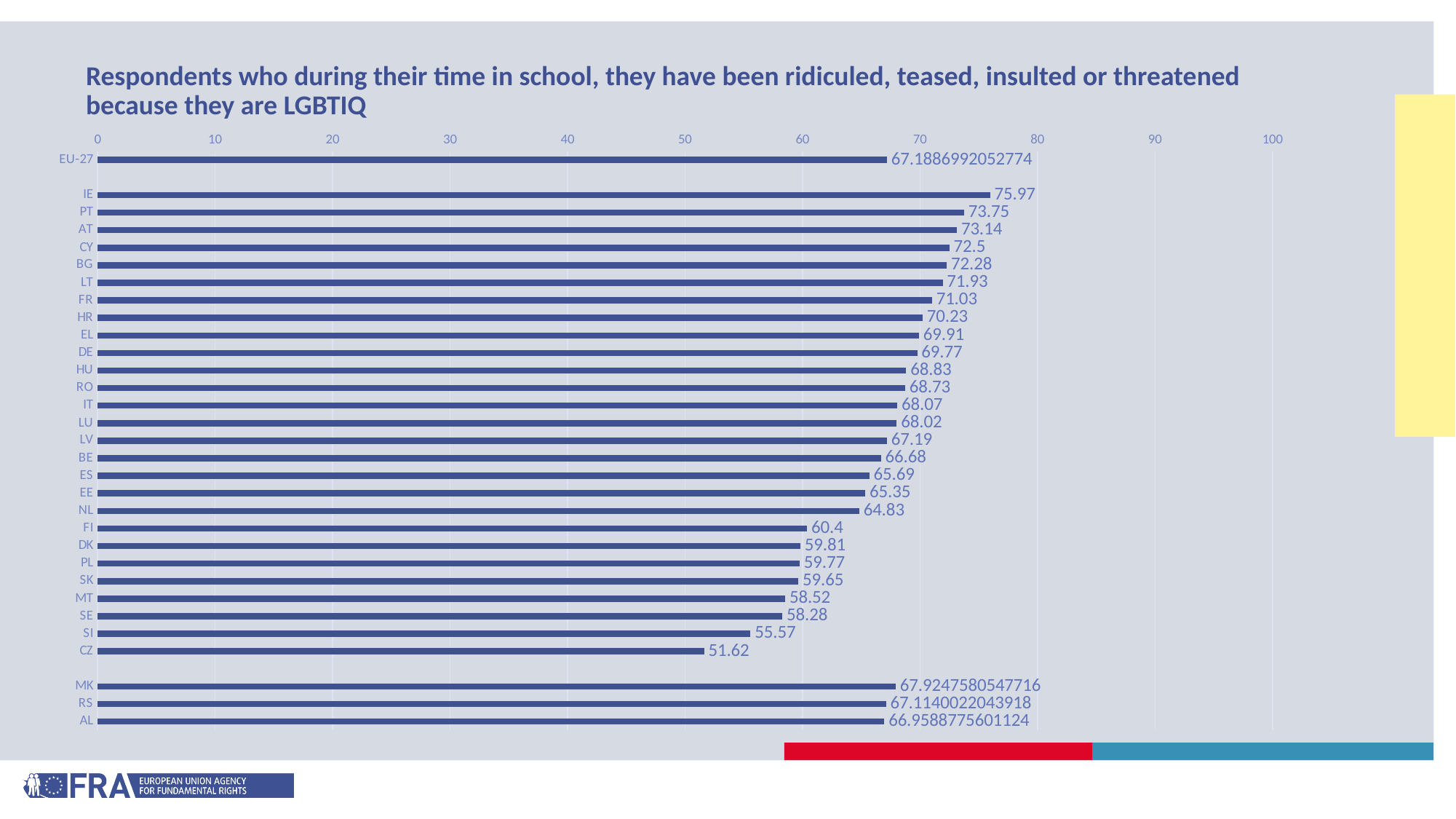
What is the difference between the values for IE and CZ? 24.35 What is the value for FR? 71.03 Which is larger, the value for PT or the value for AT? PT Is the value for SI greater or less than 60? less What kind of chart is shown on the slide? Bar chart What is the value for IE? 75.97 What is the value shown for EU-27? 67.1886992052774 Which category has the lowest value? CZ What is the value for CZ? 51.62 How many bars are plotted on the chart? 31 Do the values decrease or increase going down the chart from IE to CZ? Decrease Which category has the highest value? IE